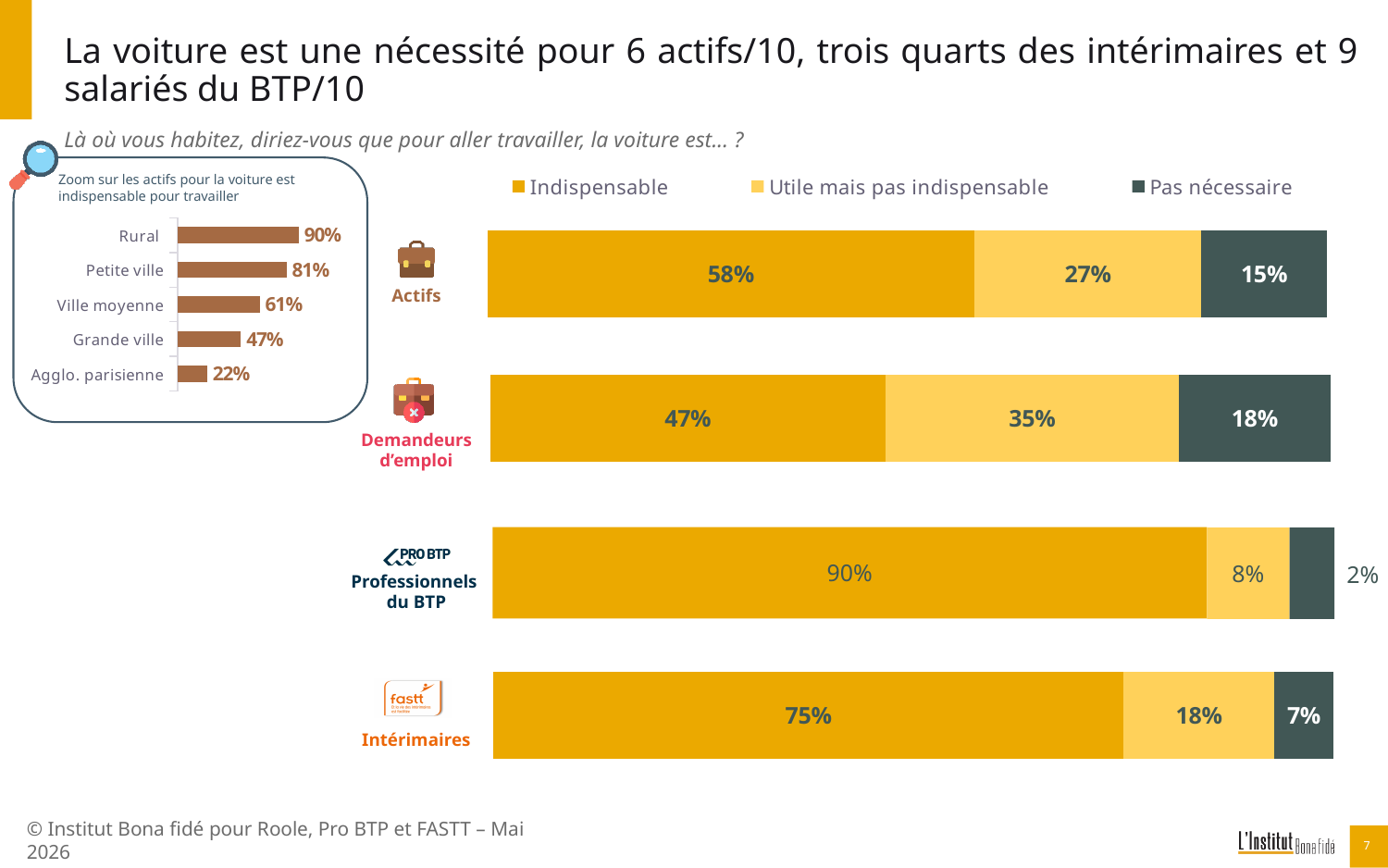
In the main stacked bar chart, how many series does the legend list? 3 In the 'Zoom sur les actifs' chart, what is the value for Rural? 90% In the main stacked bar chart, which group has the lowest share answering Indispensable? Demandeurs d'emploi In the main stacked bar chart, how many groups are shown? 4 In the main stacked bar chart, what percentage of Actifs say the car is Indispensable? 58% In the main stacked bar chart, what is the difference between the Indispensable share for Intérimaires and for Actifs? 17 percentage points What kind of chart is the 'Zoom sur les actifs' chart? Bar chart In the 'Zoom sur les actifs' chart, which category has the lowest value? Agglo. parisienne In the main stacked bar chart, which group has the highest share answering Indispensable? Professionnels du BTP In the 'Zoom sur les actifs' chart, is the value for Ville moyenne larger or smaller than the value for Grande ville? larger In the main stacked bar chart, what percentage of Professionnels du BTP say the car is Pas nécessaire? 2% In the main stacked bar chart, what percentage of Demandeurs d'emploi say the car is Utile mais pas indispensable? 35%